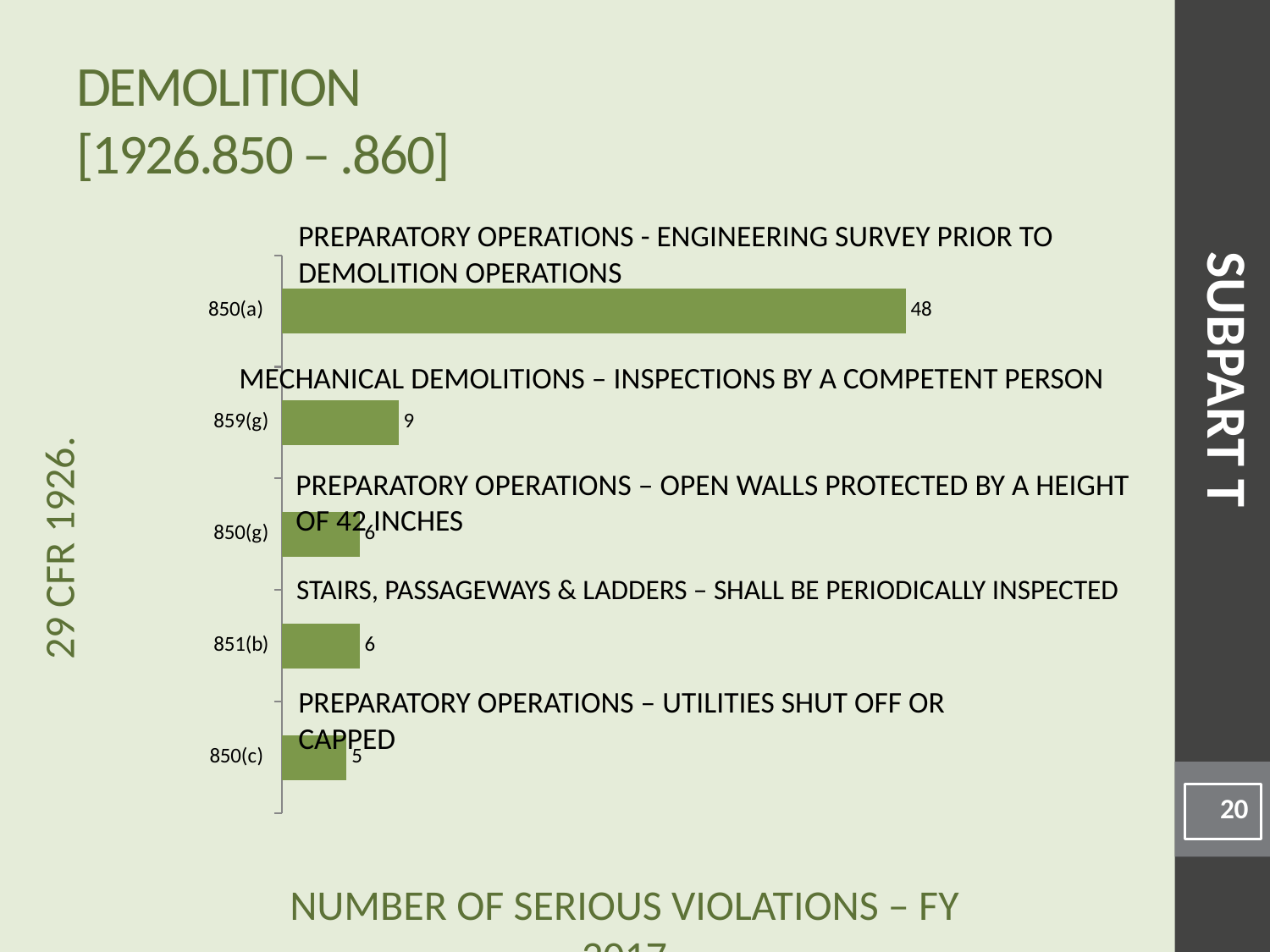
What is the number of serious violations for 859(g)? 9 Which has more serious violations, 859(g) or 851(b)? 859(g) What is the number of serious violations for 850(c)? 5 What is the number of serious violations for 851(b)? 6 Which standard has the lowest number of serious violations? 850(c) How many standards (categories) are shown in the chart? 5 What is the difference between the number of serious violations for 850(a) and 859(g)? 39 What is the description shown for the 859(g) bar? MECHANICAL DEMOLITIONS – INSPECTIONS BY A COMPETENT PERSON What kind of chart is shown on the slide? Bar chart What is the number of serious violations for 850(a)? 48 Which standard has the highest number of serious violations? 850(a) What is the total number of serious violations across all five standards shown? 74